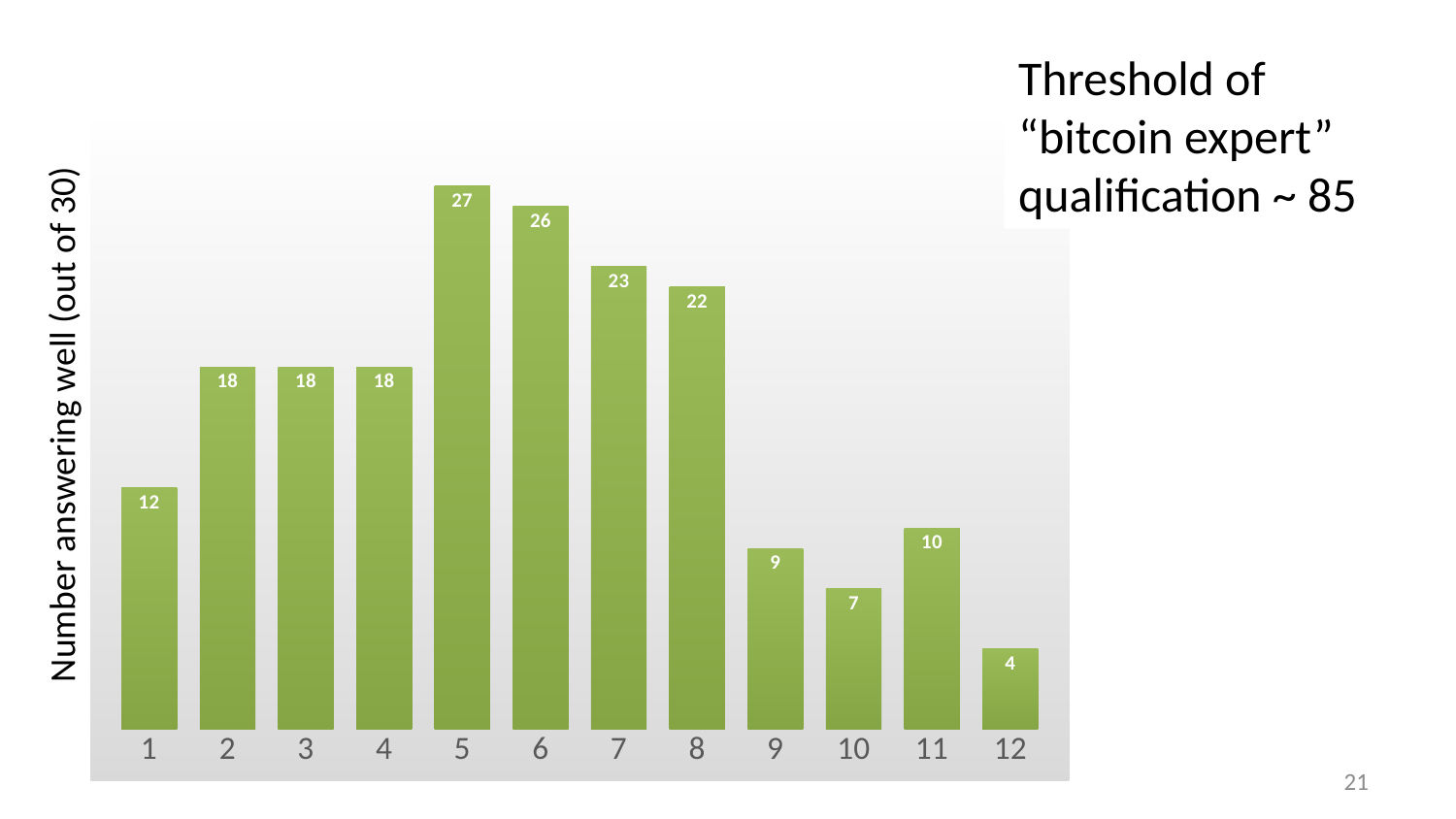
What is the value for category 9? 9 What is the difference between the values for category 1 and category 12? 8 What is the label of the vertical axis? Number answering well (out of 30) Which is larger, the value for category 7 or the value for category 8? 7 What is the value for category 5? 27 Which category has the lowest value? 12 Which category has the highest value? 5 What kind of chart is shown on the slide? bar chart How many categories are shown on the x axis? 12 What is the difference between the values for category 5 and category 6? 1 Which is larger, the value for category 10 or the value for category 11? 11 What is the value for category 12? 4